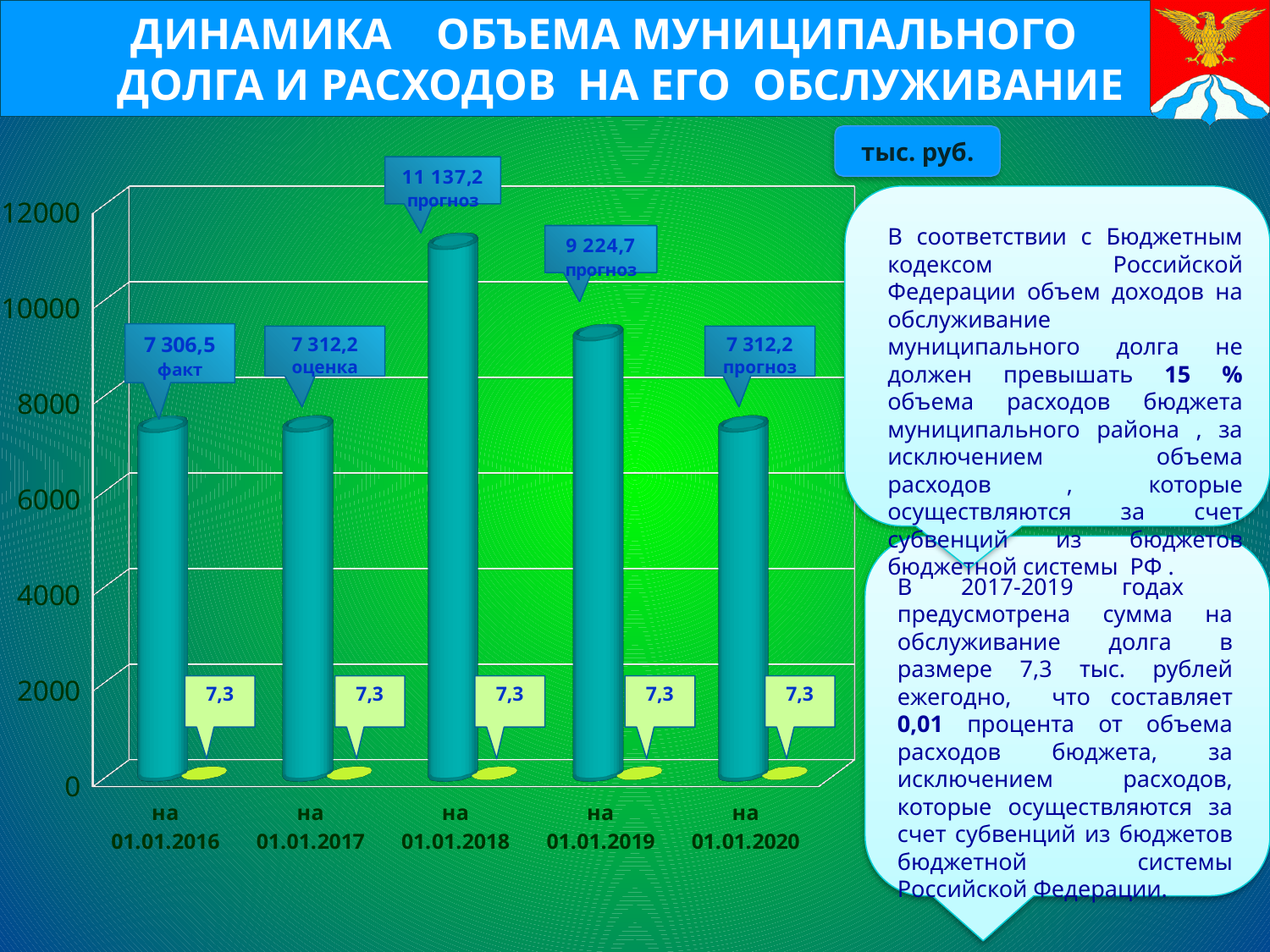
What is the municipal debt value shown for на 01.01.2018? 11 137,2 What kind of chart is shown on the slide? bar chart What is the municipal debt value shown for на 01.01.2016? 7 306,5 What is the debt servicing expense value shown for на 01.01.2020? 7,3 What unit is indicated for the chart values? тыс. руб. Which is larger, the municipal debt value for на 01.01.2019 or for на 01.01.2020? на 01.01.2019 How many dates are shown on the x axis of the chart? 5 Is the municipal debt value for на 01.01.2018 greater or less than 10000? greater Which date has the lowest municipal debt value? на 01.01.2016 What is the municipal debt value shown for на 01.01.2019? 9 224,7 What is the difference between the municipal debt values for на 01.01.2018 and на 01.01.2019? 1 912,5 Which date has the highest municipal debt value? на 01.01.2018